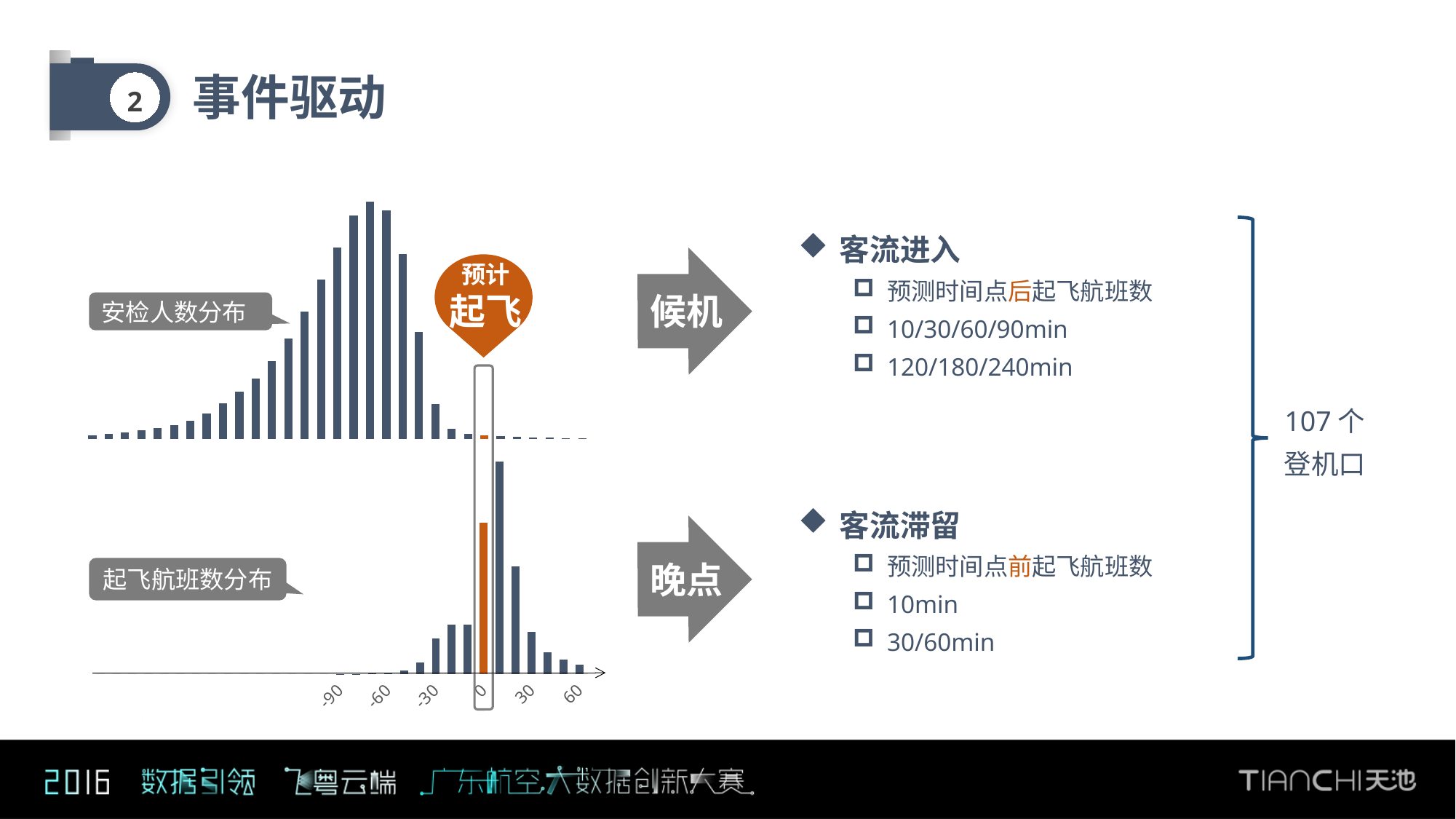
What kind of chart is the 安检人数分布 chart on the left of the slide? bar chart What text is written in the orange marker pointing at the 0 tick between the two charts? 预计起飞 In the 安检人数分布 chart, which bar is taller: the one at -60 or the one at -30? -60 In the 安检人数分布 chart, near which labelled x-axis tick is the tallest bar? -60 In the 起飞航班数分布 chart, is the tallest bar to the left or to the right of the 0 tick? right In the 起飞航班数分布 chart, do the bars rise or fall as the x axis goes from 30 to 60? fall What colour is the highlighted bar at the 0 tick in the 起飞航班数分布 chart? orange What kind of chart is the 起飞航班数分布 chart at the bottom left of the slide? bar chart In the 起飞航班数分布 chart, which bar is taller: the one at 0 or the one at 60? 0 In the 安检人数分布 chart, do the bars rise or fall as the x axis goes from -60 to 0? fall How many labelled ticks are shown on the shared x axis of the two charts? 6 In the 安检人数分布 chart, do the bars rise or fall as the x axis goes from -90 to -60? rise